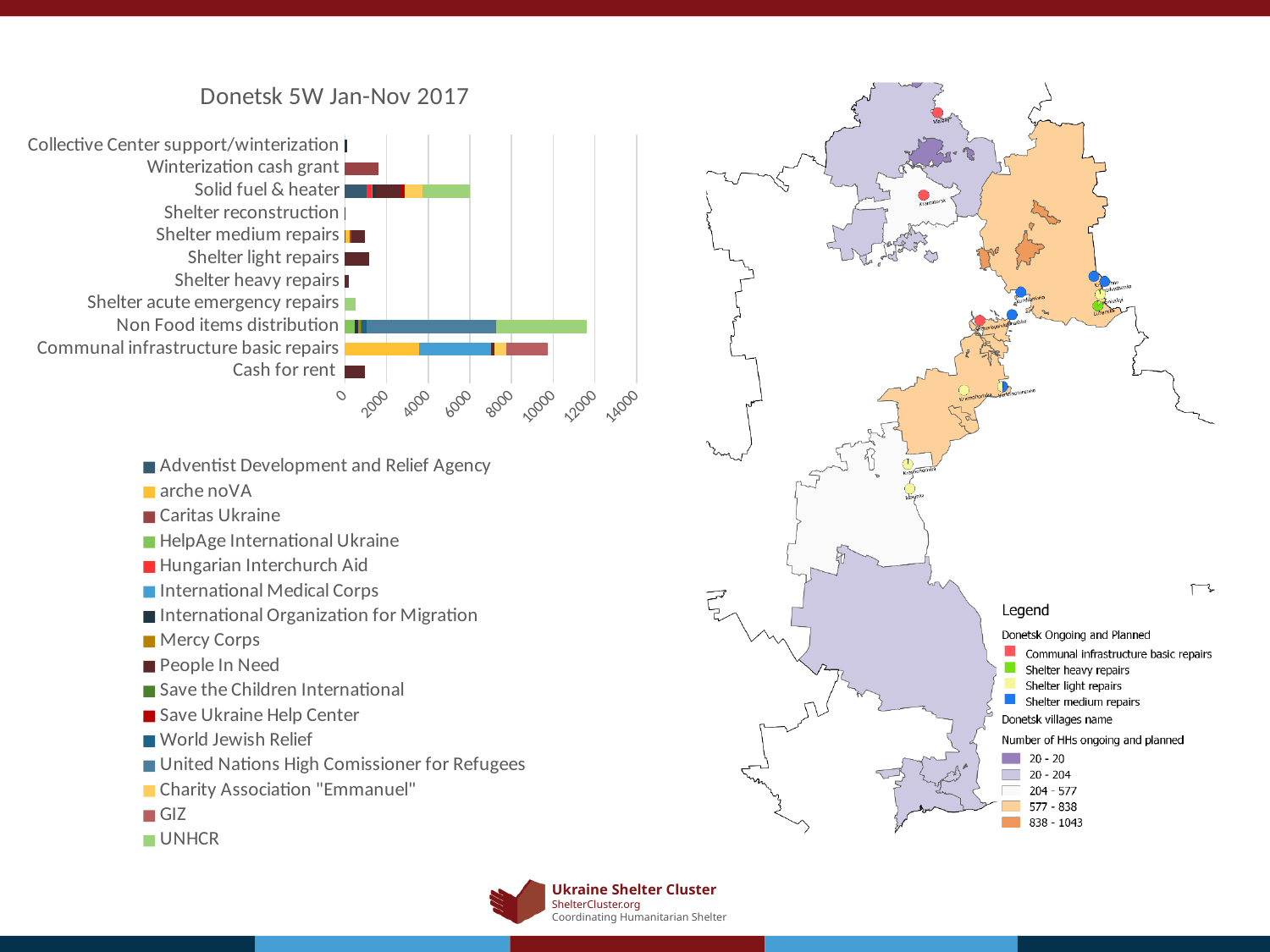
Which has a larger total: Solid fuel & heater or Winterization cash grant? Solid fuel & heater How many series does the chart legend list? 16 Is the total value for Solid fuel & heater greater or less than 8000? less How many categories are shown on the chart's vertical axis? 11 Which category has the longest bar in the chart? Non Food items distribution Is the total value for Winterization cash grant greater or less than 2000? less What kind of chart is shown on the slide? bar chart Is the total value for Cash for rent greater or less than 2000? less Which has a larger total: Non Food items distribution or Communal infrastructure basic repairs? Non Food items distribution What is the title of the chart? Donetsk 5W Jan-Nov 2017